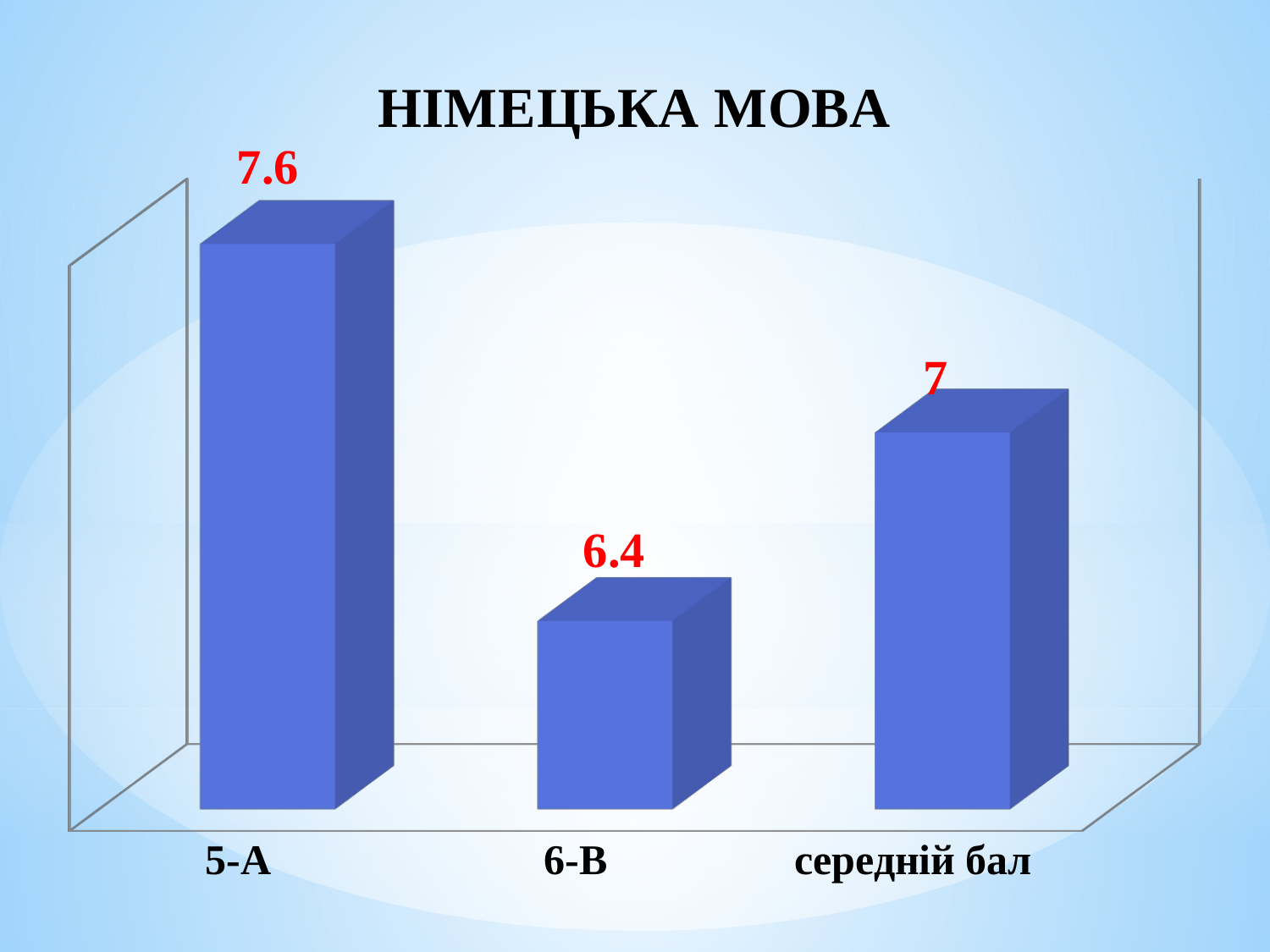
What kind of chart is shown on the slide? bar chart Which is larger, the value for 6-В or the value for середній бал? середній бал What colour are the bars in the chart? blue What is the value for 5-А? 7.6 What is the difference between the values for 5-А and середній бал? 0.6 Which category has the lowest value? 6-В Which category has the highest value? 5-А What is the value for середній бал? 7 What is the difference between the values for 5-А and 6-В? 1.2 How many categories are shown in the chart? 3 What is the value for 6-В? 6.4 What is the title of the slide? НІМЕЦЬКА МОВА